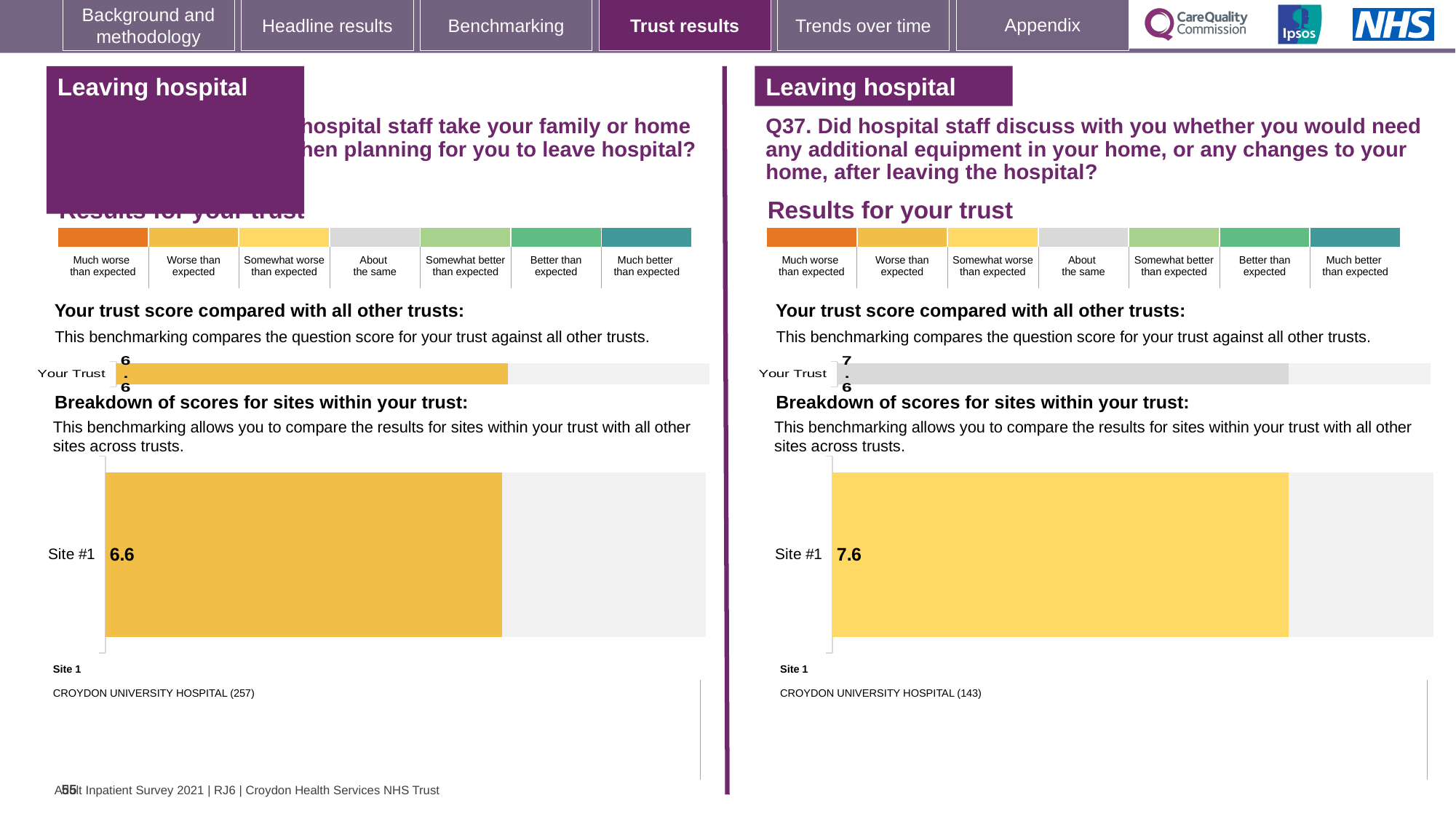
On the left-hand 'Your trust score compared with all other trusts' bar, what is the value shown for Your Trust? 6.6 On the right-hand 'Your trust score compared with all other trusts' bar for Q37, what is the value shown for Your Trust? 7.6 What is the difference between the Site #1 score on the right-hand chart for Q37 and the Site #1 score on the left-hand chart? 1.0 On the right-hand chart for Q37, what is the score shown for Site #1? 7.6 How many sites are shown in the right-hand 'Breakdown of scores for sites within your trust' chart for Q37? 1 Which hospital is listed as Site 1 on the left-hand side of the slide? CROYDON UNIVERSITY HOSPITAL (257) How many sites are shown in the left-hand 'Breakdown of scores for sites within your trust' chart? 1 On the left-hand chart, what is the score shown for Site #1? 6.6 Which hospital is listed as Site 1 on the right-hand side of the slide for Q37? CROYDON UNIVERSITY HOSPITAL (143) On the right-hand chart for Q37, is the Site #1 score greater or less than 7? greater Which is larger: the Site #1 score on the left-hand chart or the Site #1 score on the right-hand chart for Q37? Right-hand chart (Q37) What kind of chart is used to show the Site #1 score on the left-hand side of the slide? Bar chart